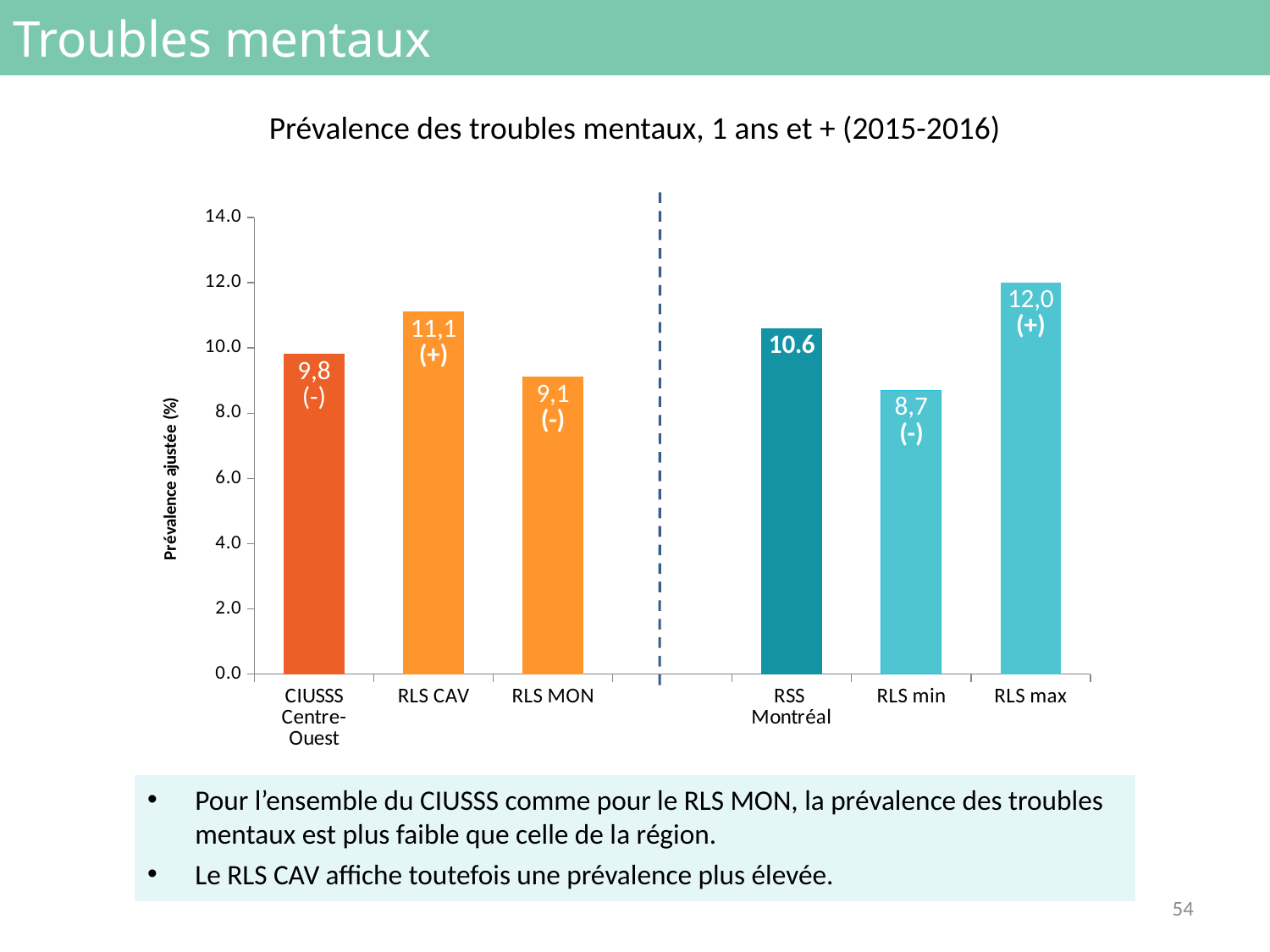
What is the value for RLS MON? 9,1 Which is larger, the value for RLS CAV or the value for RSS Montréal? RLS CAV What is the title of the chart? Prévalence des troubles mentaux, 1 ans et + (2015-2016) How many categories are shown on the x axis? 6 What is the value for RSS Montréal? 10.6 Which category has the lowest value? RLS min What kind of chart is shown? bar chart Which category has the highest value? RLS max What is the difference between the values for RLS max and RLS min? 3,3 Is the value for RLS MON greater or less than 10.0? less What is the value for RLS CAV? 11,1 What is the value for CIUSSS Centre-Ouest? 9,8